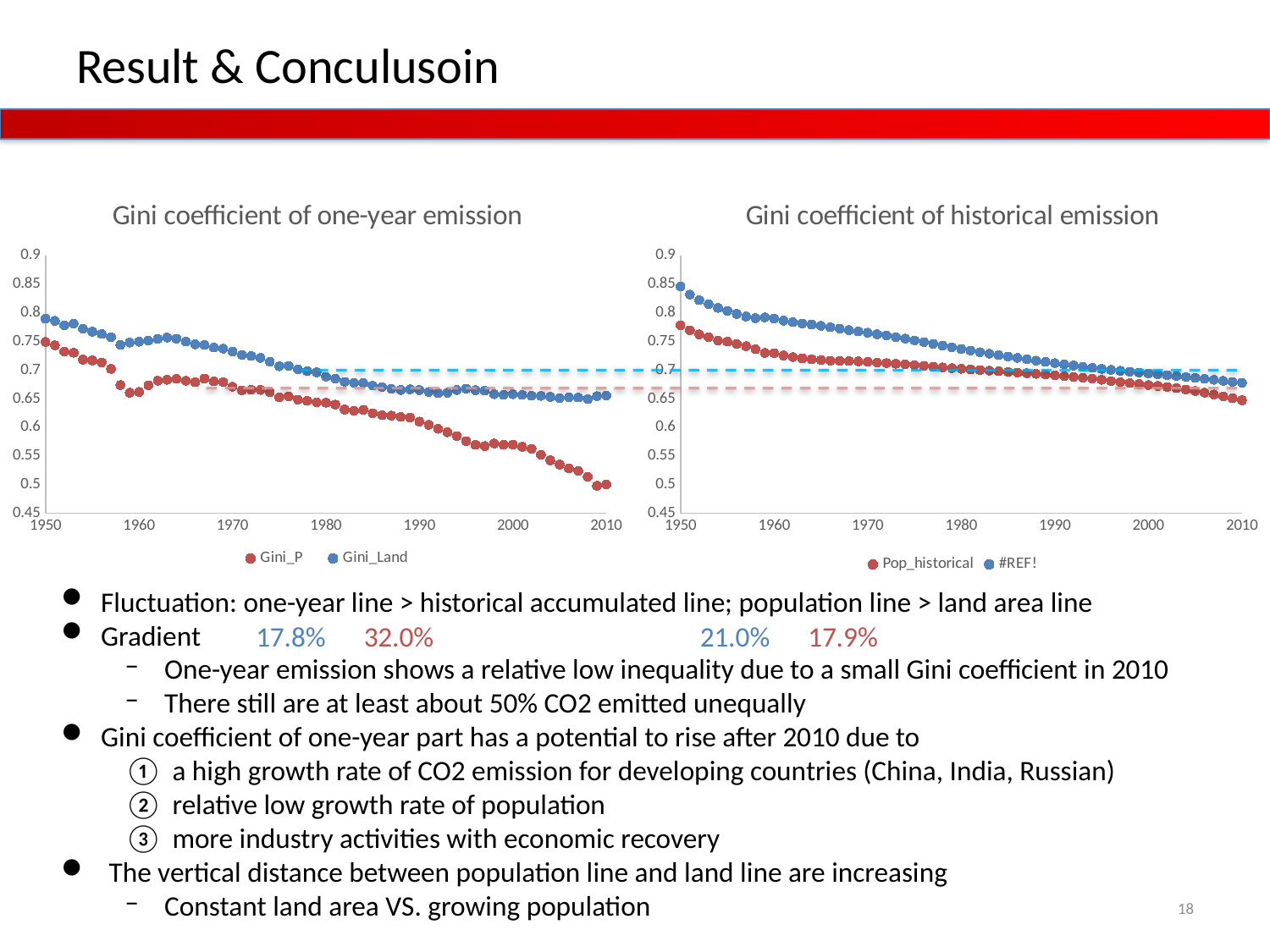
What kind of chart is the 'Gini coefficient of one-year emission' chart? scatter chart In the 'Gini coefficient of historical emission' chart, does the #REF! series rise or fall from 1950 to 2010? fall In the 'Gini coefficient of historical emission' chart, which series has the higher value in 1950, Pop_historical or #REF!? #REF! In the 'Gini coefficient of one-year emission' chart, is the Gini_P value in 2010 greater or less than 0.6? less In the 'Gini coefficient of one-year emission' chart, is the Gini_Land value in 1950 greater or less than 0.75? greater How many series does the legend of the 'Gini coefficient of one-year emission' chart list? 2 What are the legend entries of the chart on the right of the slide? Pop_historical and #REF! In the 'Gini coefficient of historical emission' chart, is the #REF! value in 1950 greater or less than 0.8? greater How many series does the legend of the 'Gini coefficient of historical emission' chart list? 2 In the 'Gini coefficient of one-year emission' chart, does the Gini_P series rise or fall from 1950 to 2010? fall In the 'Gini coefficient of one-year emission' chart, which series has the higher value in 2010, Gini_P or Gini_Land? Gini_Land